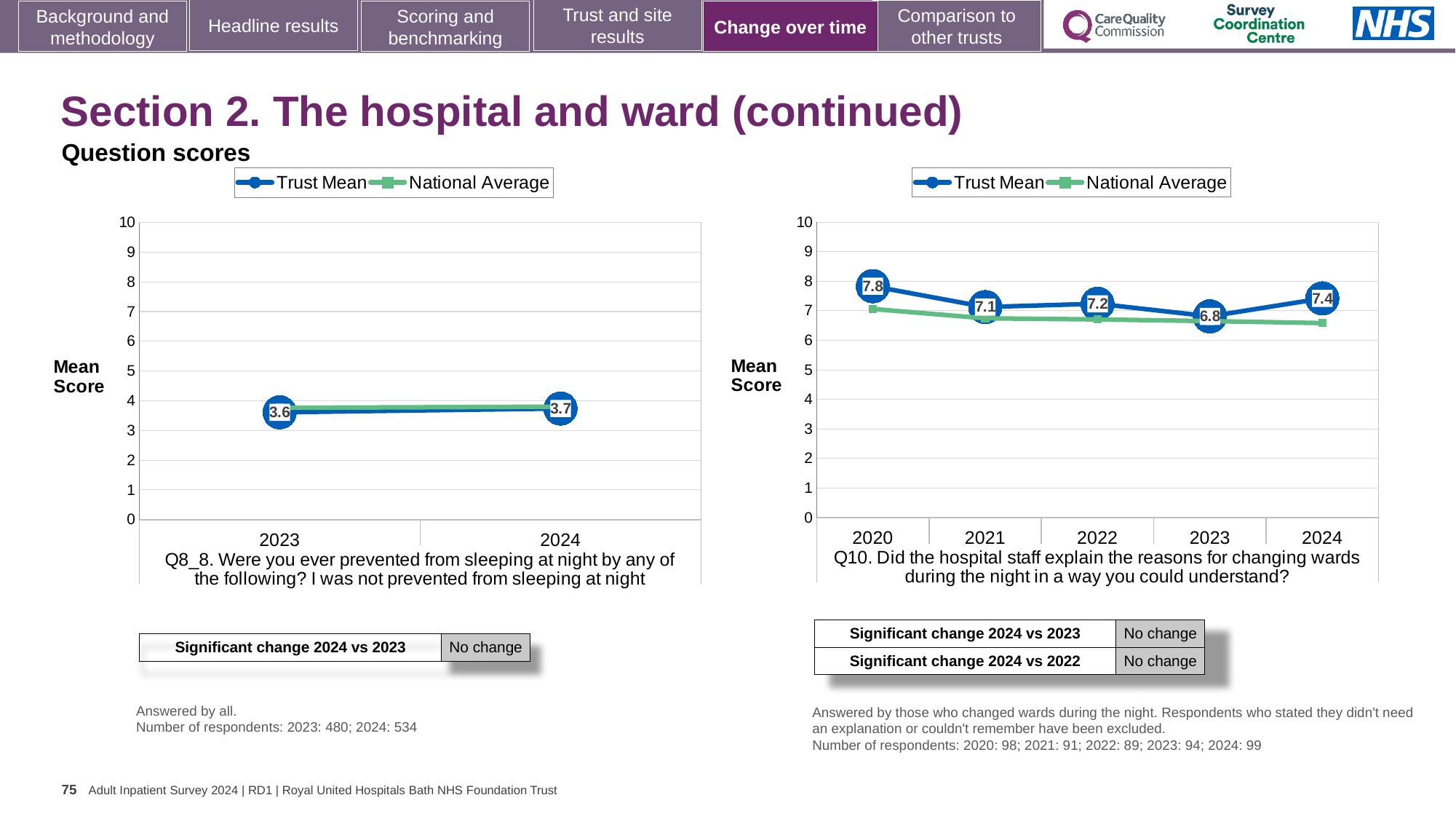
On the right chart (Q10), is the Trust Mean score higher in 2022 or in 2024? 2024 On the right chart (Q10), what is the Trust Mean score for 2023? 6.8 What type of chart is the left chart (Q8_8)? Line chart On the right chart (Q10), is the National Average value for 2024 greater or less than 7? less How many years are shown on the x axis of the right chart (Q10)? 5 On the right chart (Q10), what is the Trust Mean score for 2020? 7.8 On the left chart (Q8_8), what is the Trust Mean score for 2024? 3.7 On the left chart (Q8_8), what is the Trust Mean score for 2023? 3.6 On the right chart (Q10), what is the difference between the Trust Mean scores for 2020 and 2023? 1.0 On the right chart (Q10), which year has the highest Trust Mean score? 2020 How many series does the legend of the left chart (Q8_8) list? 2 On the right chart (Q10), which year has the lowest Trust Mean score? 2023